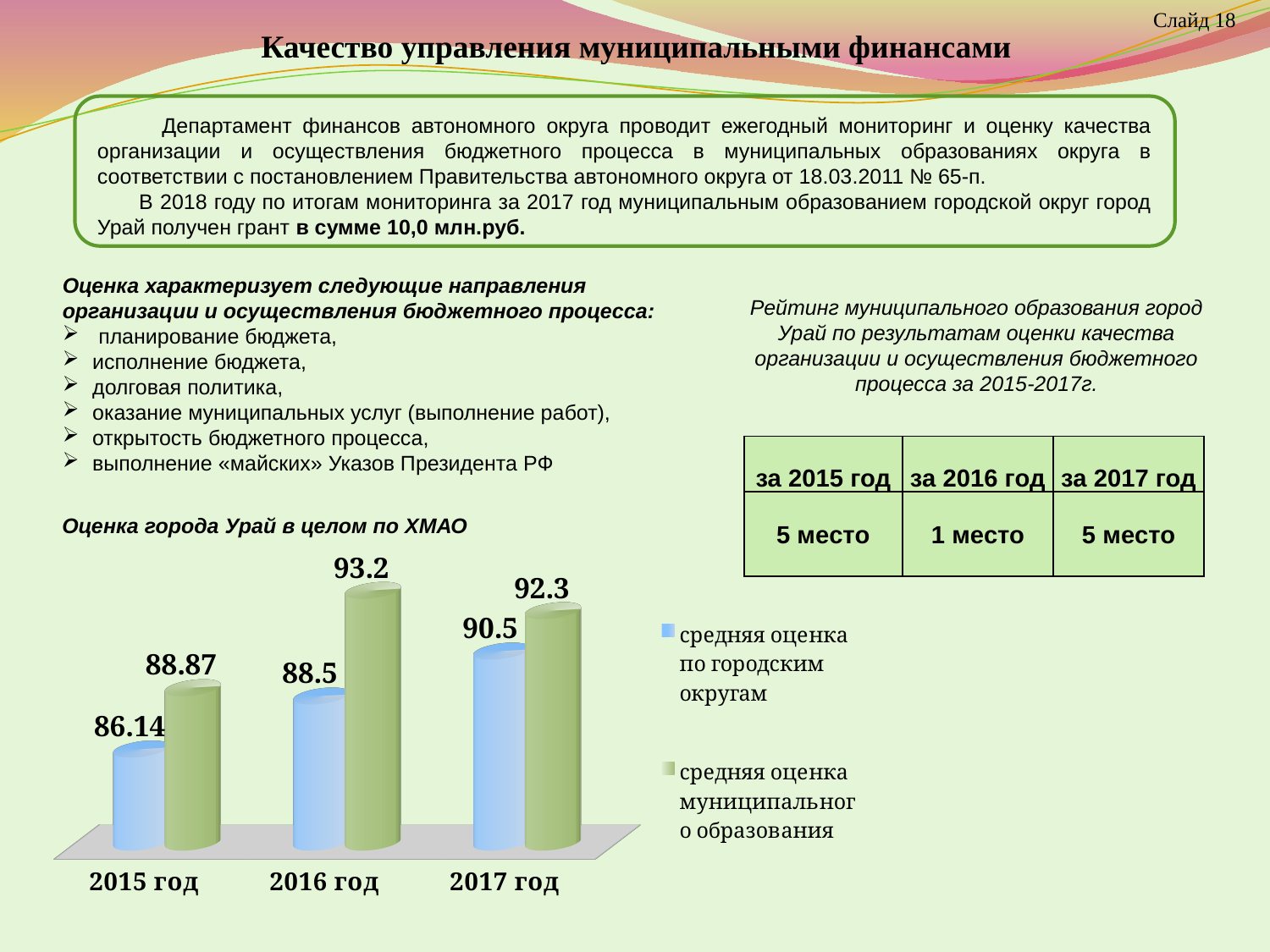
How many series does the chart legend list? 2 What is the value of 'средняя оценка муниципального образования' for 2015 год? 88.87 How many years are shown on the x axis of the chart? 3 What is the value of 'средняя оценка по городским округам' for 2015 год? 86.14 In which year is 'средняя оценка муниципального образования' the highest? 2016 год In which year is 'средняя оценка по городским округам' the lowest? 2015 год What is the value of 'средняя оценка муниципального образования' for 2016 год? 93.2 What is the difference between 'средняя оценка муниципального образования' and 'средняя оценка по городским округам' in 2016 год? 4.7 What is the value of 'средняя оценка по городским округам' for 2017 год? 90.5 Which is larger in 2017 год: 'средняя оценка по городским округам' or 'средняя оценка муниципального образования'? средняя оценка муниципального образования What kind of chart is shown on the slide? bar chart Does 'средняя оценка по городским округам' rise or fall from 2015 год to 2017 год? rise